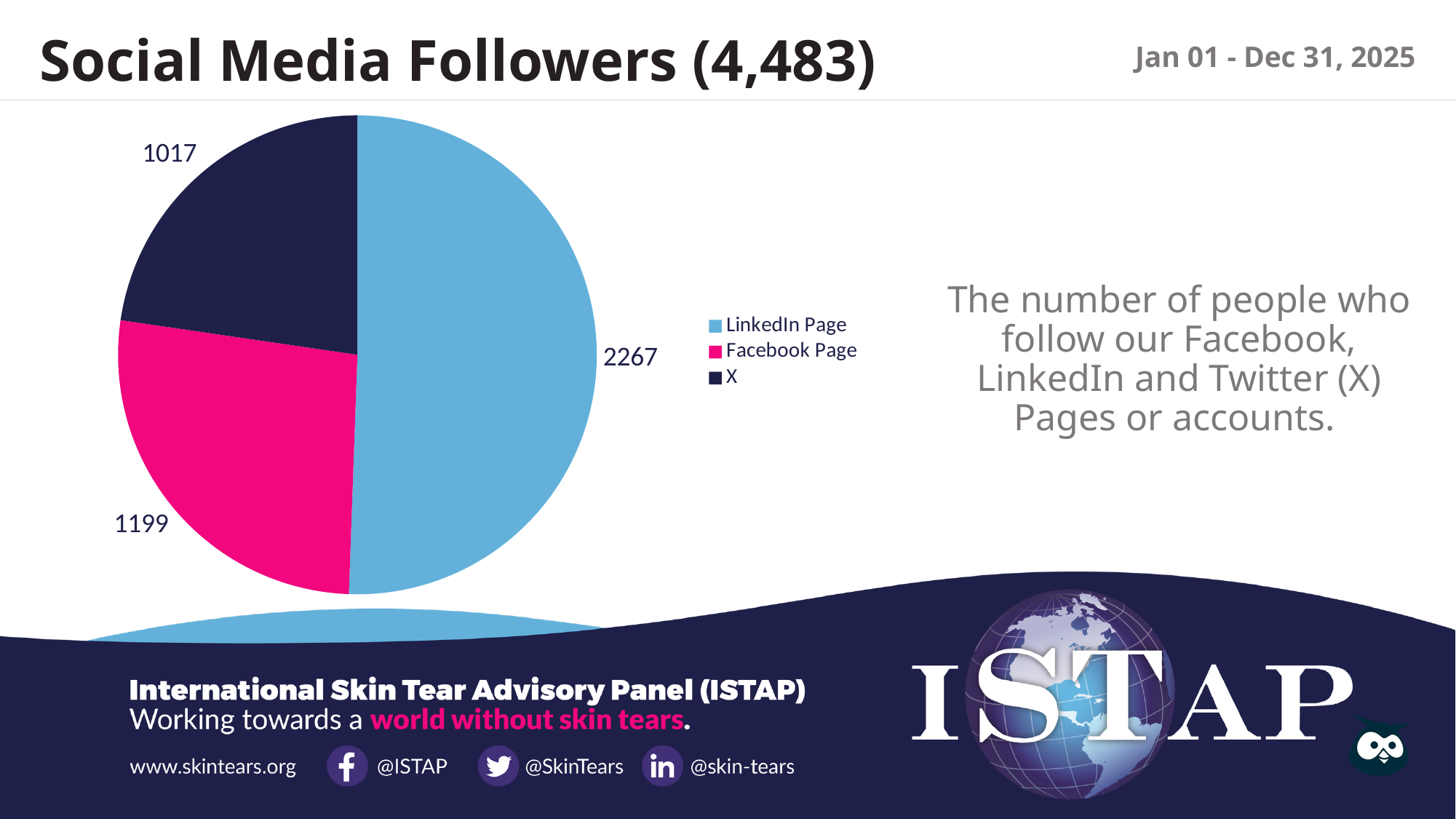
How many followers does the Facebook Page have? 1199 How many platforms are shown in the pie chart? 3 What is the total number of followers across all three platforms? 4,483 How many followers does X have? 1017 What is the difference in followers between the Facebook Page and X? 182 Which platform has the fewest followers? X What colour represents the Facebook Page in the pie chart? Pink How many followers does the LinkedIn Page have? 2267 Which has more followers, the Facebook Page or X? Facebook Page What is the difference in followers between the LinkedIn Page and the Facebook Page? 1068 Which platform has the most followers? LinkedIn Page What type of chart is shown on the slide? Pie chart